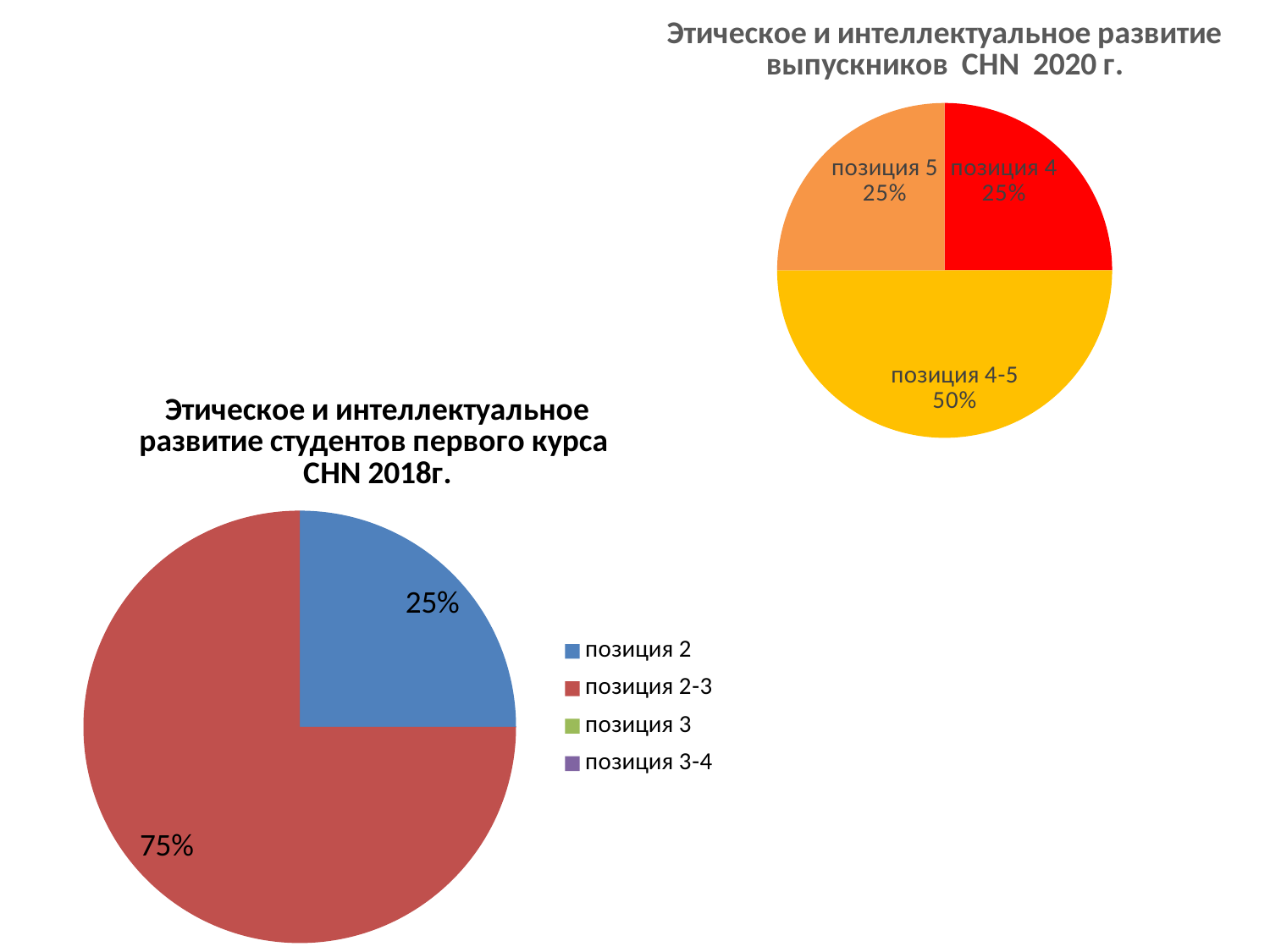
How many slices does the chart titled "Этическое и интеллектуальное развитие выпускников CHN 2020 г." have? 3 In the chart titled "Этическое и интеллектуальное развитие студентов первого курса CHN 2018г.", what colour is the "позиция 2" slice? blue In the chart titled "Этическое и интеллектуальное развитие выпускников CHN 2020 г.", what share does "позиция 4-5" have? 50% In the chart titled "Этическое и интеллектуальное развитие выпускников CHN 2020 г.", which slice is the largest? позиция 4-5 In the chart titled "Этическое и интеллектуальное развитие выпускников CHN 2020 г.", what is the difference between the shares of "позиция 4-5" and "позиция 4"? 25% In the chart titled "Этическое и интеллектуальное развитие студентов первого курса CHN 2018г.", what share does the "позиция 2-3" slice have? 75% In the chart titled "Этическое и интеллектуальное развитие студентов первого курса CHN 2018г.", what is the difference between the shares of "позиция 2-3" and "позиция 2"? 50% What kind of chart is the chart titled "Этическое и интеллектуальное развитие выпускников CHN 2020 г."? pie chart In the chart titled "Этическое и интеллектуальное развитие студентов первого курса CHN 2018г.", what share does the "позиция 2" slice have? 25% In the chart titled "Этическое и интеллектуальное развитие студентов первого курса CHN 2018г.", which slice is larger: "позиция 2" or "позиция 2-3"? позиция 2-3 How many entries does the legend of the chart titled "Этическое и интеллектуальное развитие студентов первого курса CHN 2018г." list? 4